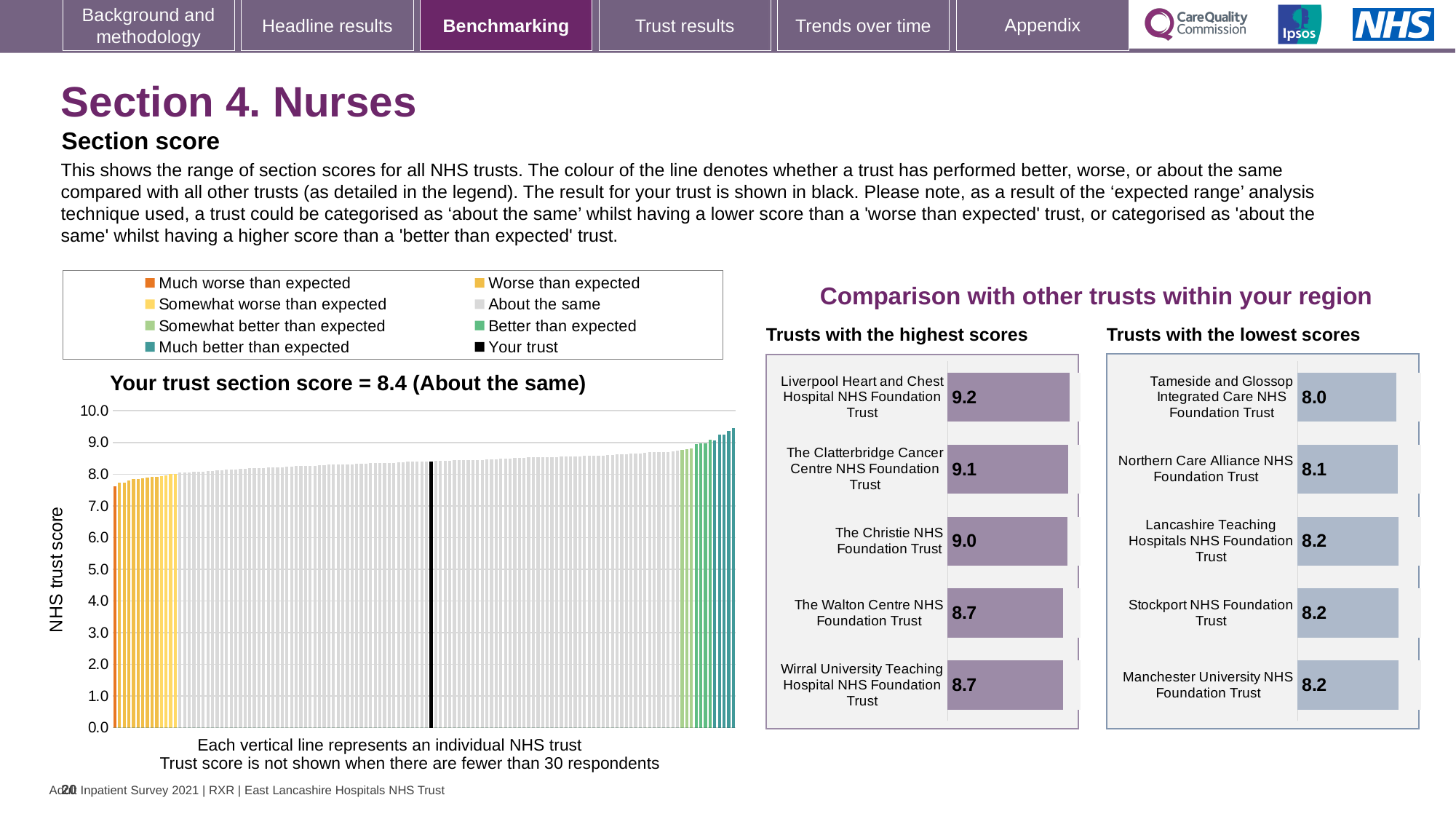
In the main chart on the left, is the value of the lowest-scoring trust greater or less than 8.0? less In the main chart on the left, what is your trust's section score as stated in the chart title? 8.4 What kind of chart is the main chart on the left showing the range of section scores? Bar chart In the 'Trusts with the highest scores' chart, what is the difference between the scores of Liverpool Heart and Chest Hospital NHS Foundation Trust and The Christie NHS Foundation Trust? 0.2 In the 'Trusts with the lowest scores' chart, what is the difference between the scores of Stockport NHS Foundation Trust and Tameside and Glossop Integrated Care NHS Foundation Trust? 0.2 In the 'Trusts with the lowest scores' chart, which trust has the lowest score? Tameside and Glossop Integrated Care NHS Foundation Trust How many trusts are listed in the 'Trusts with the highest scores' chart? 5 In the 'Trusts with the lowest scores' chart, what is the score for Northern Care Alliance NHS Foundation Trust? 8.1 In the 'Trusts with the highest scores' chart, what is the score for The Christie NHS Foundation Trust? 9.0 In the 'Trusts with the highest scores' chart, which trust has the highest score? Liverpool Heart and Chest Hospital NHS Foundation Trust In the 'Trusts with the lowest scores' chart, which has the larger score: Northern Care Alliance NHS Foundation Trust or Tameside and Glossop Integrated Care NHS Foundation Trust? Northern Care Alliance NHS Foundation Trust How many entries does the legend above the main chart on the left list? 8